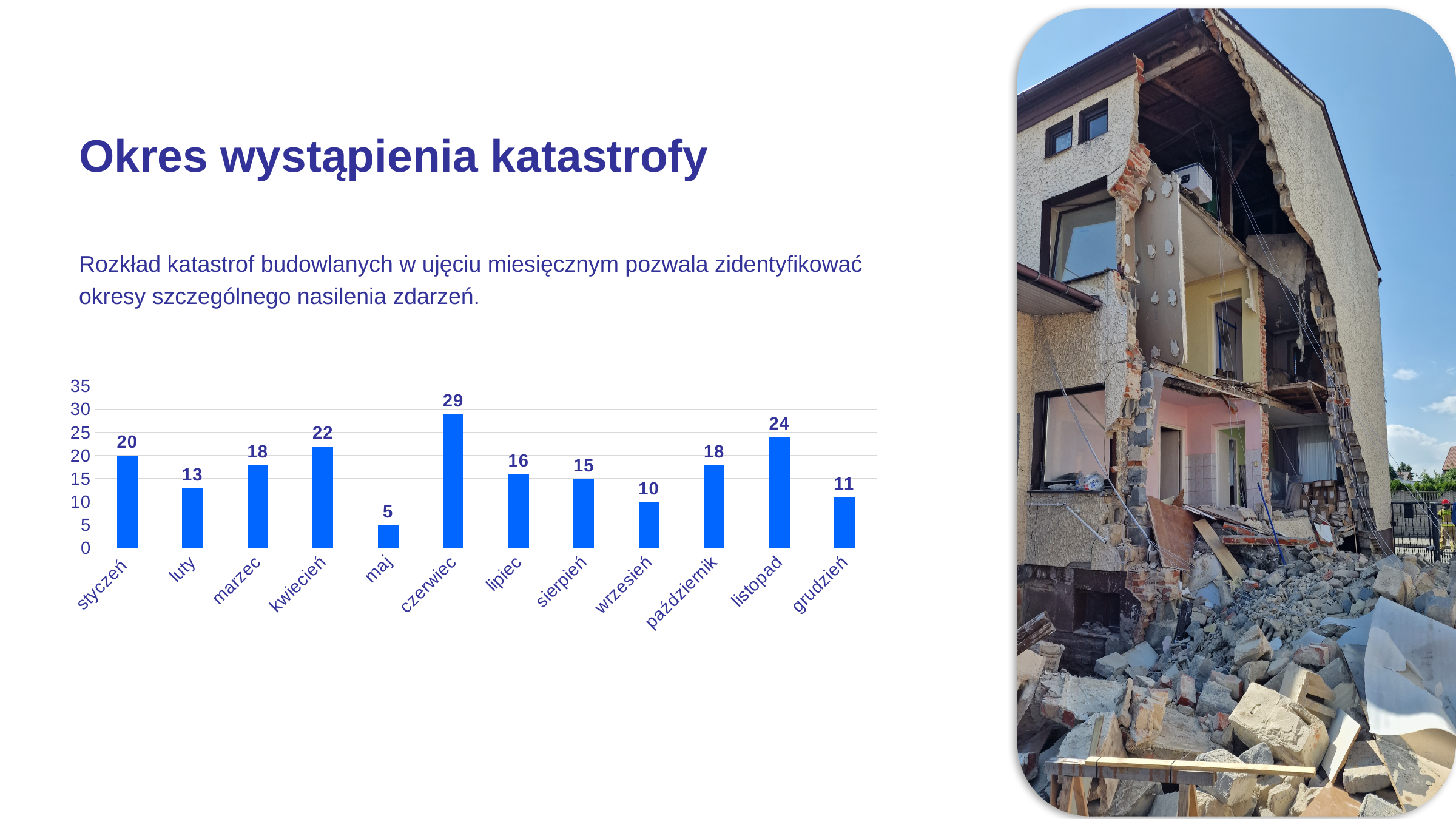
What is the value for listopad? 24 Which month has the lowest value? maj Which is larger, the value for styczeń or the value for grudzień? styczeń What is the value for maj? 5 What is the value for czerwiec? 29 Is the value for listopad greater or less than 20? greater What is the difference between the values for czerwiec and maj? 24 How many months are shown on the x axis? 12 Do the values rise or fall from czerwiec to wrzesień? fall What kind of chart is shown on the slide? bar chart What is the difference between the values for kwiecień and luty? 9 Which month has the highest value? czerwiec